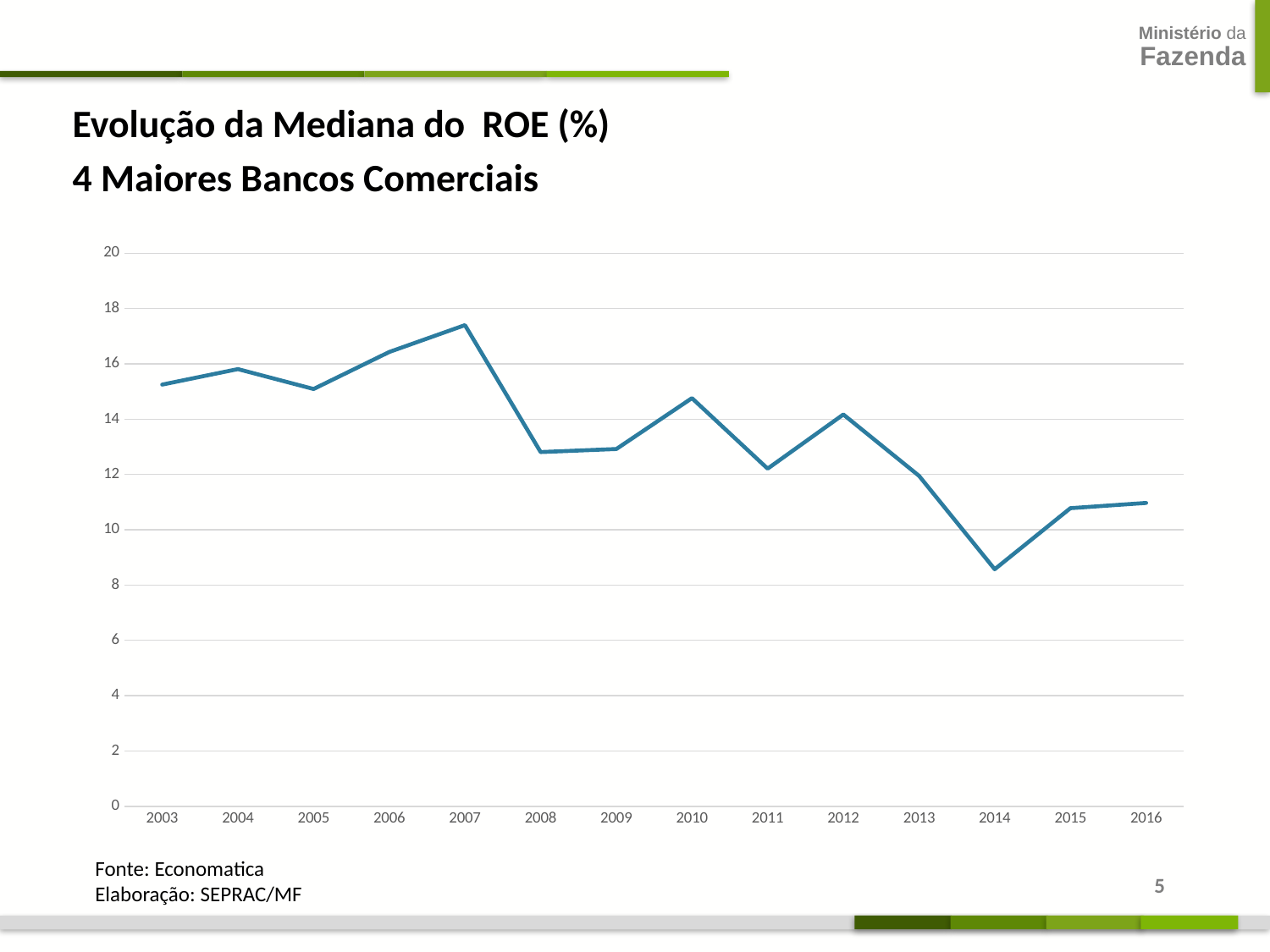
Which is larger, the value for 2010 or the value for 2011? 2010 Is the value for 2007 greater or less than 16? greater Is the value for 2014 greater or less than 10? less Which year has the lowest median ROE value? 2014 How many years are plotted on the x axis? 14 What is the title of the chart? Evolução da Mediana do ROE (%) 4 Maiores Bancos Comerciais What kind of chart is shown on the slide? line chart Which year has the highest median ROE value? 2007 Which is larger, the value for 2012 or the value for 2013? 2012 Is the value for 2003 greater or less than 14? greater Overall, do the values rise or fall from 2003 to 2016? fall